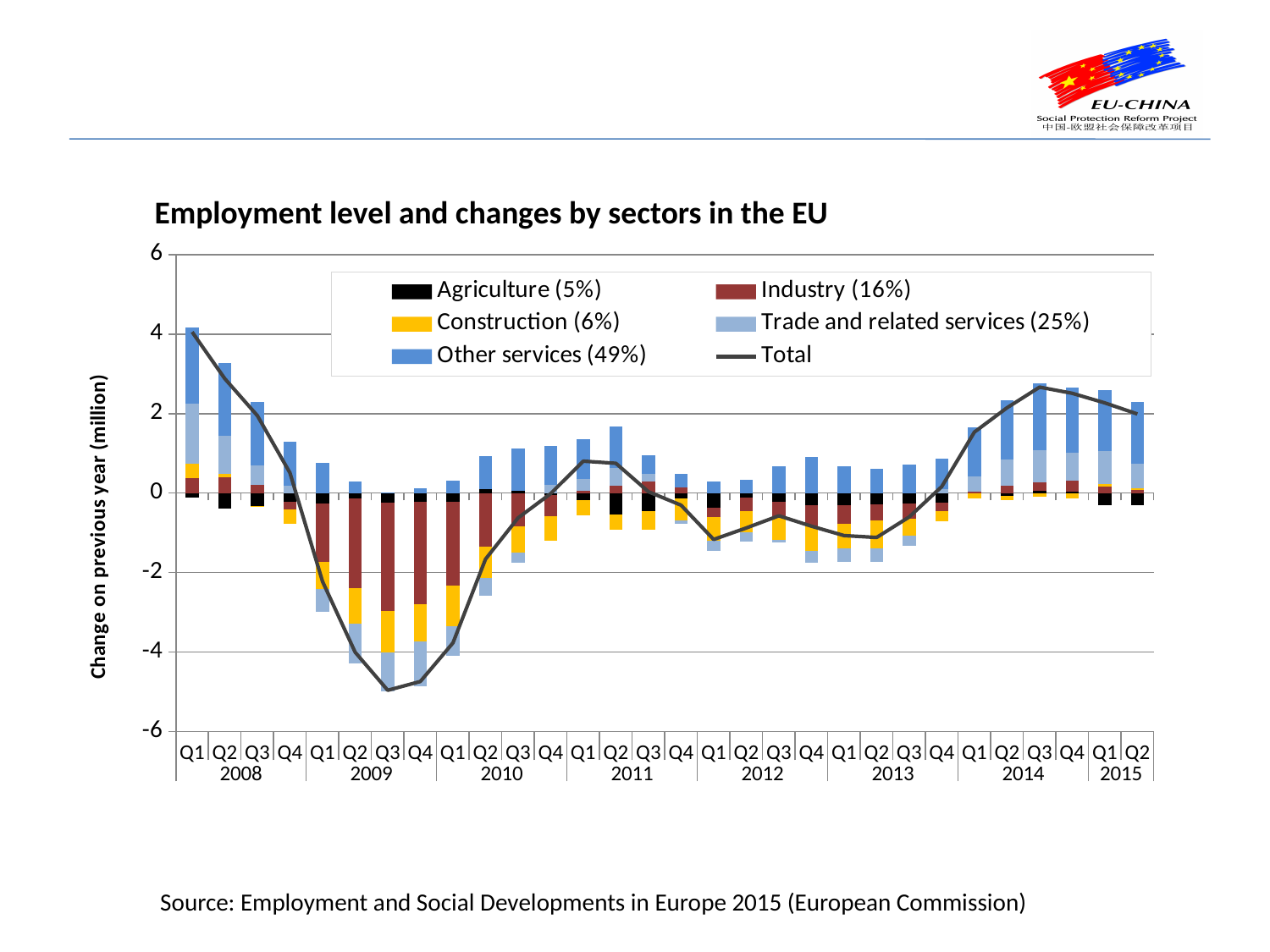
Does the Total line rise or fall from Q1 2008 to Q3 2009? Fall In which quarter does the Total line reach its highest point? Q1 2008 Is the Total value for Q3 2009 greater or less than -4? less What is the title of the chart? Employment level and changes by sectors in the EU How many series does the legend list? 6 How many quarters are plotted along the x axis? 30 In which quarter does the Total line reach its lowest point? Q3 2009 Which has the larger Total value, Q1 2008 or Q3 2014? Q1 2008 What percentage is shown in the legend next to Other services? 49% What kind of chart is shown on the slide? Stacked bar chart with a line Is the Total value for Q1 2012 greater or less than 0? less Is the Total value for Q1 2008 greater or less than 2? greater